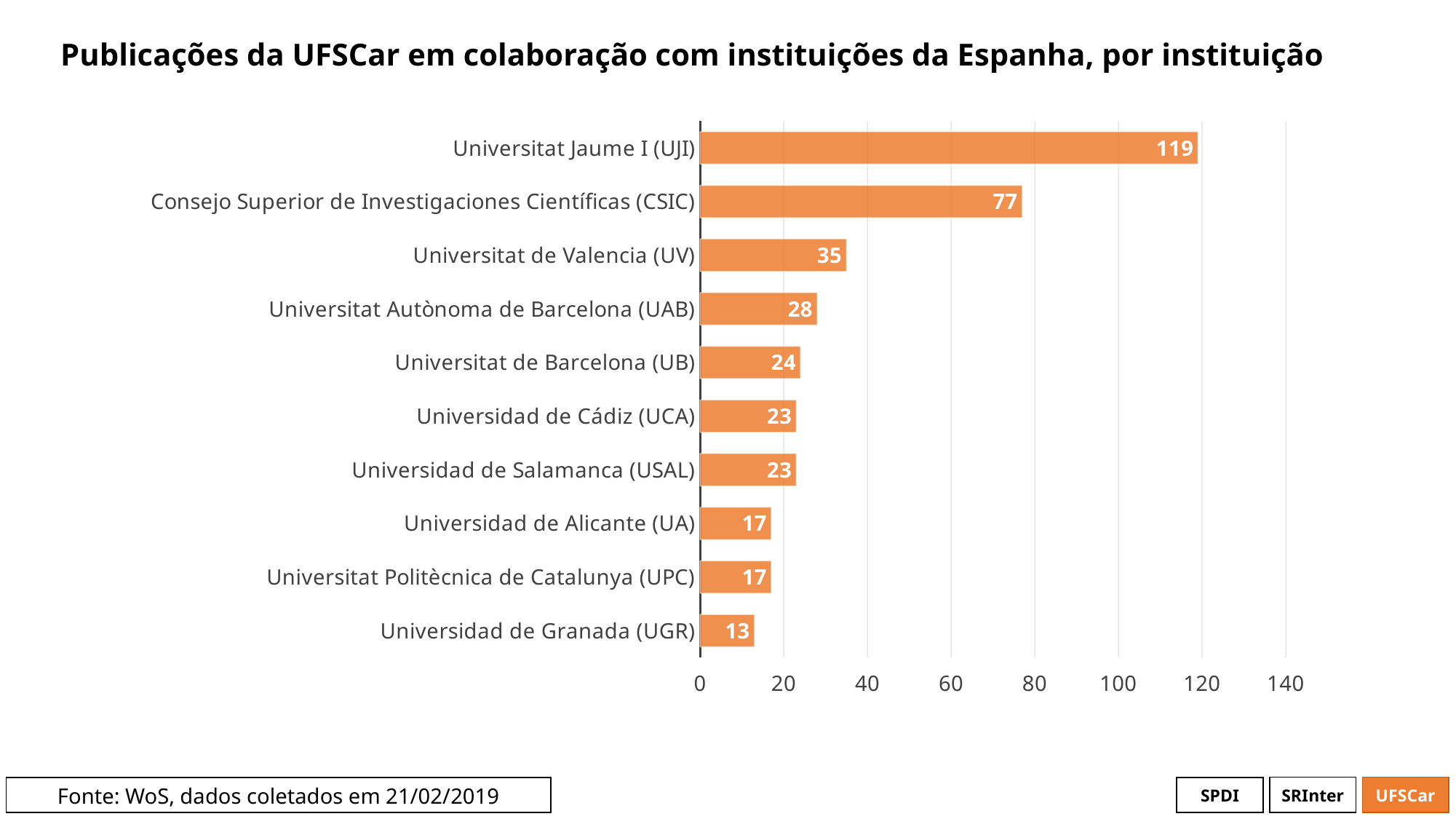
How many publications does the chart show for Universitat Jaume I (UJI)? 119 Which institution has the highest number of publications in collaboration with UFSCar? Universitat Jaume I (UJI) What is the difference between the values for Universitat Jaume I (UJI) and Consejo Superior de Investigaciones Científicas (CSIC)? 42 Which institution has the lowest value on the chart? Universidad de Granada (UGR) What is the difference between the values for Universitat de Valencia (UV) and Universitat Autònoma de Barcelona (UAB)? 7 What is the value shown for Universidad de Granada (UGR)? 13 What is the title of the chart? Publicações da UFSCar em colaboração com instituições da Espanha, por instituição Which has a larger value, Universitat de Barcelona (UB) or Universidad de Alicante (UA)? Universitat de Barcelona (UB) What is the value for Consejo Superior de Investigaciones Científicas (CSIC)? 77 How many institutions are shown on the chart? 10 Is the value for Consejo Superior de Investigaciones Científicas (CSIC) greater or less than 80? less What kind of chart is shown on the slide? bar chart